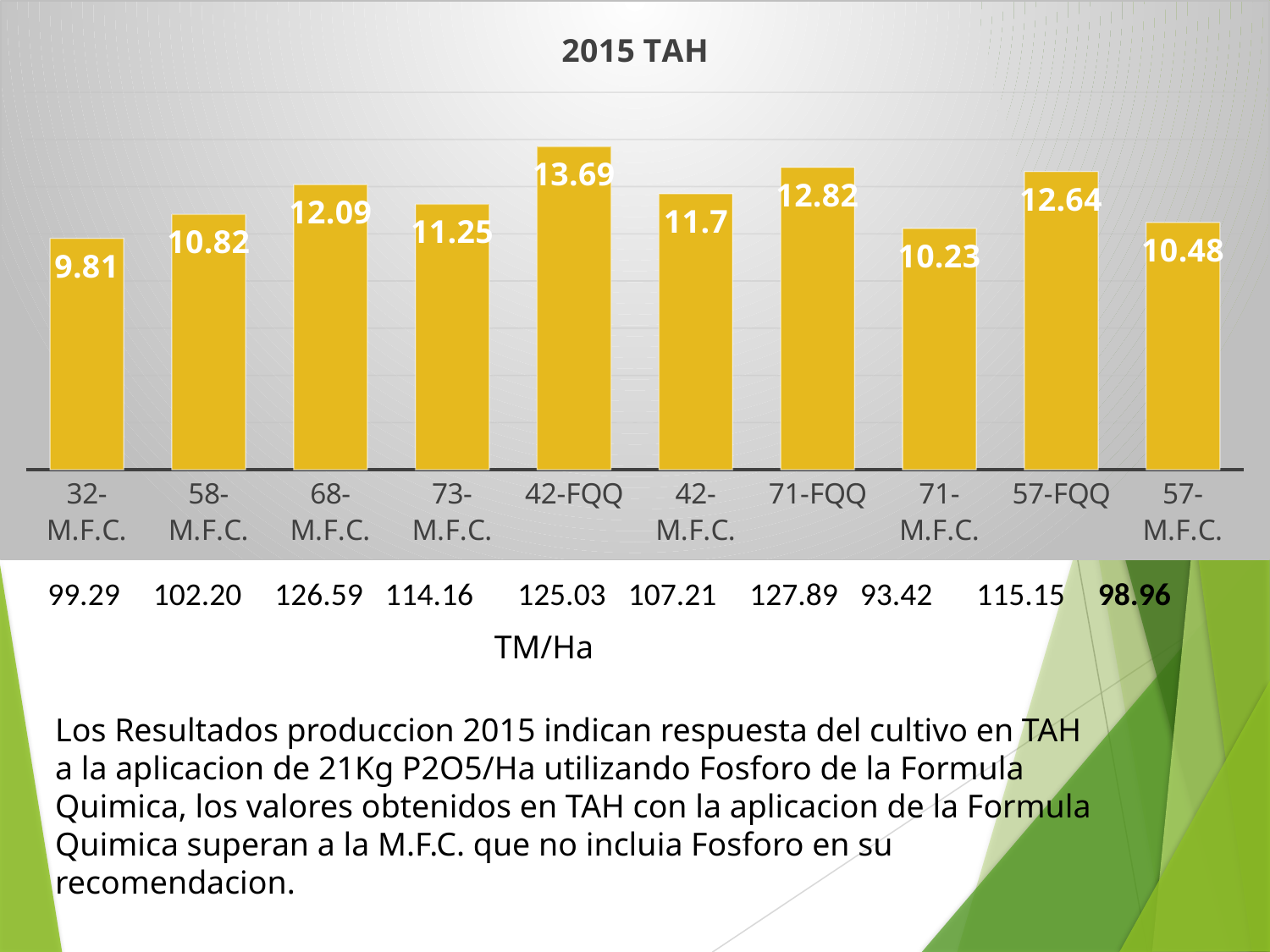
Which category has the highest value? 42-FQQ What kind of chart is shown on the slide? bar chart What is the difference between the values for 57-FQQ and 57-M.F.C.? 2.16 Which is larger, the value for 68-M.F.C. or the value for 73-M.F.C.? 68-M.F.C. Which category has the lowest value? 32-M.F.C. What is the value for 71-M.F.C.? 10.23 How many categories are shown in the chart? 10 What is the value for 32-M.F.C.? 9.81 What is the title of the chart? 2015 TAH Which is larger, the value for 71-FQQ or the value for 71-M.F.C.? 71-FQQ What is the difference between the values for 42-FQQ and 42-M.F.C.? 1.99 What is the value for 42-FQQ? 13.69